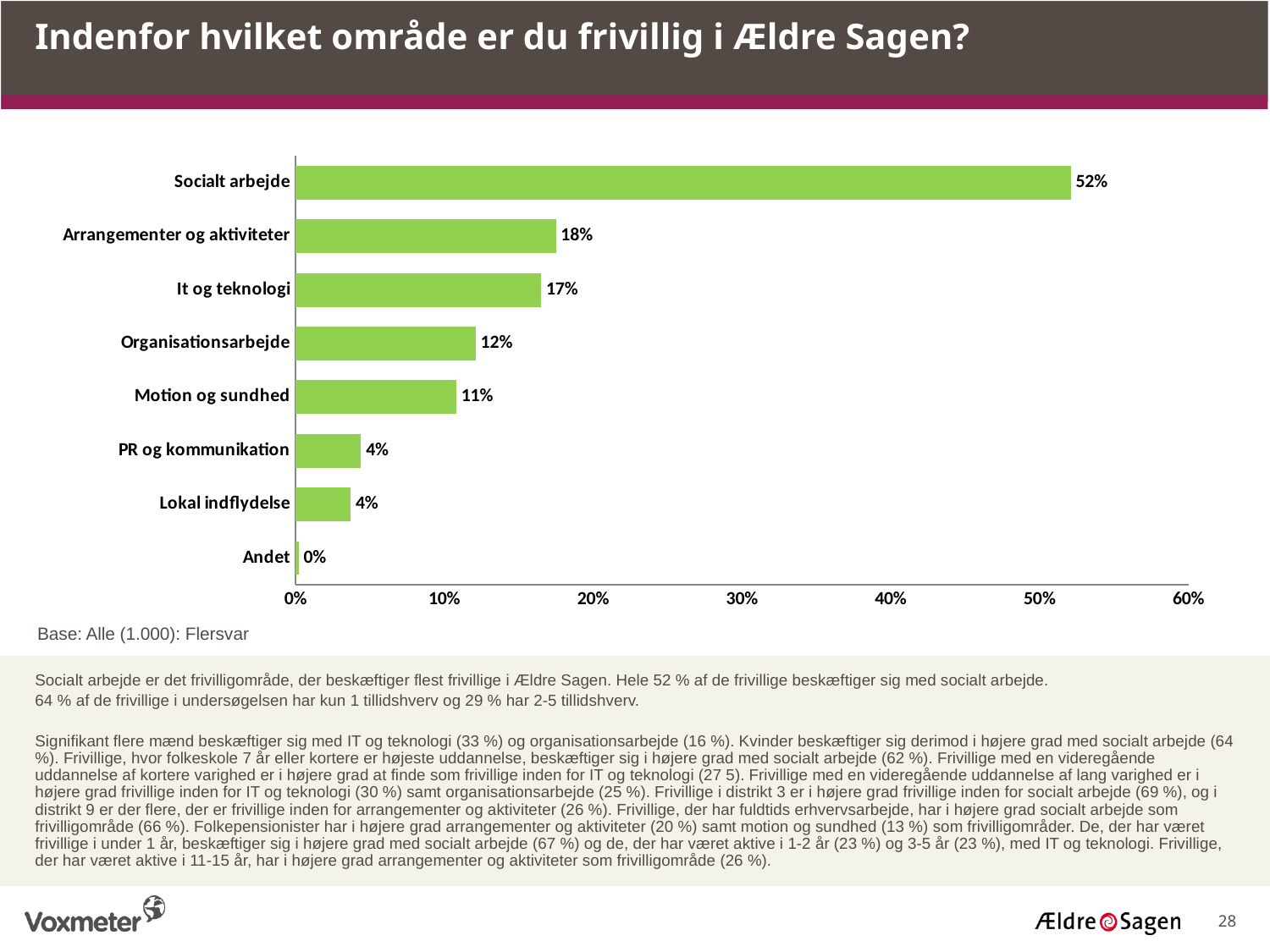
What is the difference between Socialt arbejde and Arrangementer og aktiviteter? 34% What is the value for It og teknologi? 17% Is the value for Socialt arbejde greater or less than 50%? greater What is the value for Socialt arbejde? 52% What is the difference between Organisationsarbejde and PR og kommunikation? 8% How many categories are shown in the chart? 8 What is the title of the chart? Indenfor hvilket område er du frivillig i Ældre Sagen? Which category has the highest value? Socialt arbejde Which category has the lowest value? Andet What kind of chart is shown on the slide? Bar chart Which is larger, Arrangementer og aktiviteter or Organisationsarbejde? Arrangementer og aktiviteter What is the value for Motion og sundhed? 11%